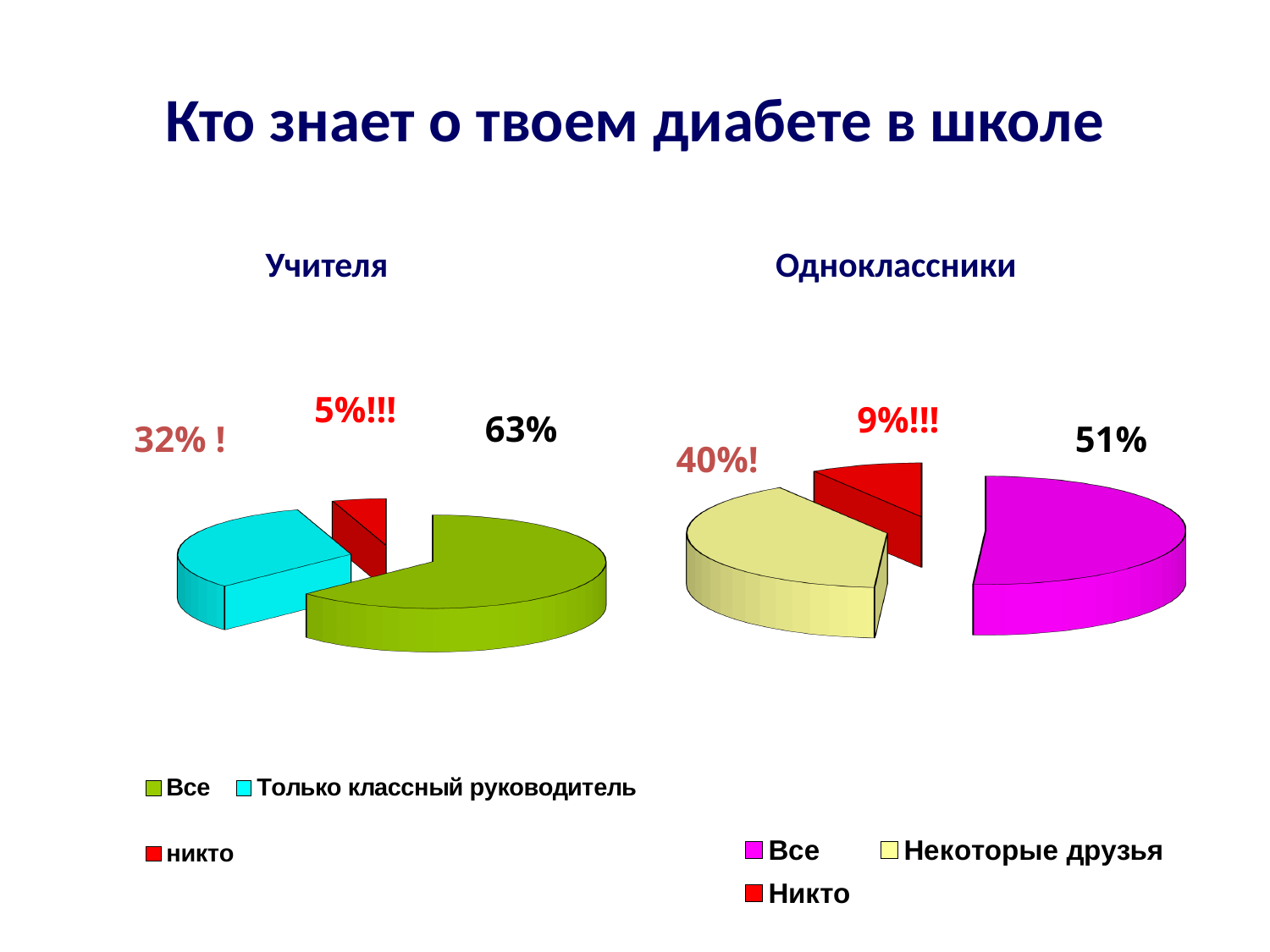
In the 'Одноклассники' pie chart, what share is shown for 'Все'? 51% How many slices does the 'Учителя' pie chart have? 3 In the 'Учителя' pie chart, which category has the largest slice? Все In the 'Одноклассники' pie chart, which category has the smallest slice? Никто Which is larger: the 'никто' share in the 'Учителя' chart or the 'Никто' share in the 'Одноклассники' chart? Никто in Одноклассники In the 'Учителя' pie chart, what share is shown for 'никто'? 5% In the 'Учителя' pie chart, what share is shown for 'Только классный руководитель'? 32% In the 'Одноклассники' pie chart, what share is shown for 'Некоторые друзья'? 40% What type of chart is used for 'Одноклассники'? Pie chart In the 'Одноклассники' pie chart, what is the difference between the 'Все' and 'Некоторые друзья' shares? 11% In the 'Учителя' pie chart, what share is shown for 'Все'? 63% In the 'Одноклассники' pie chart, what share is shown for 'Никто'? 9%